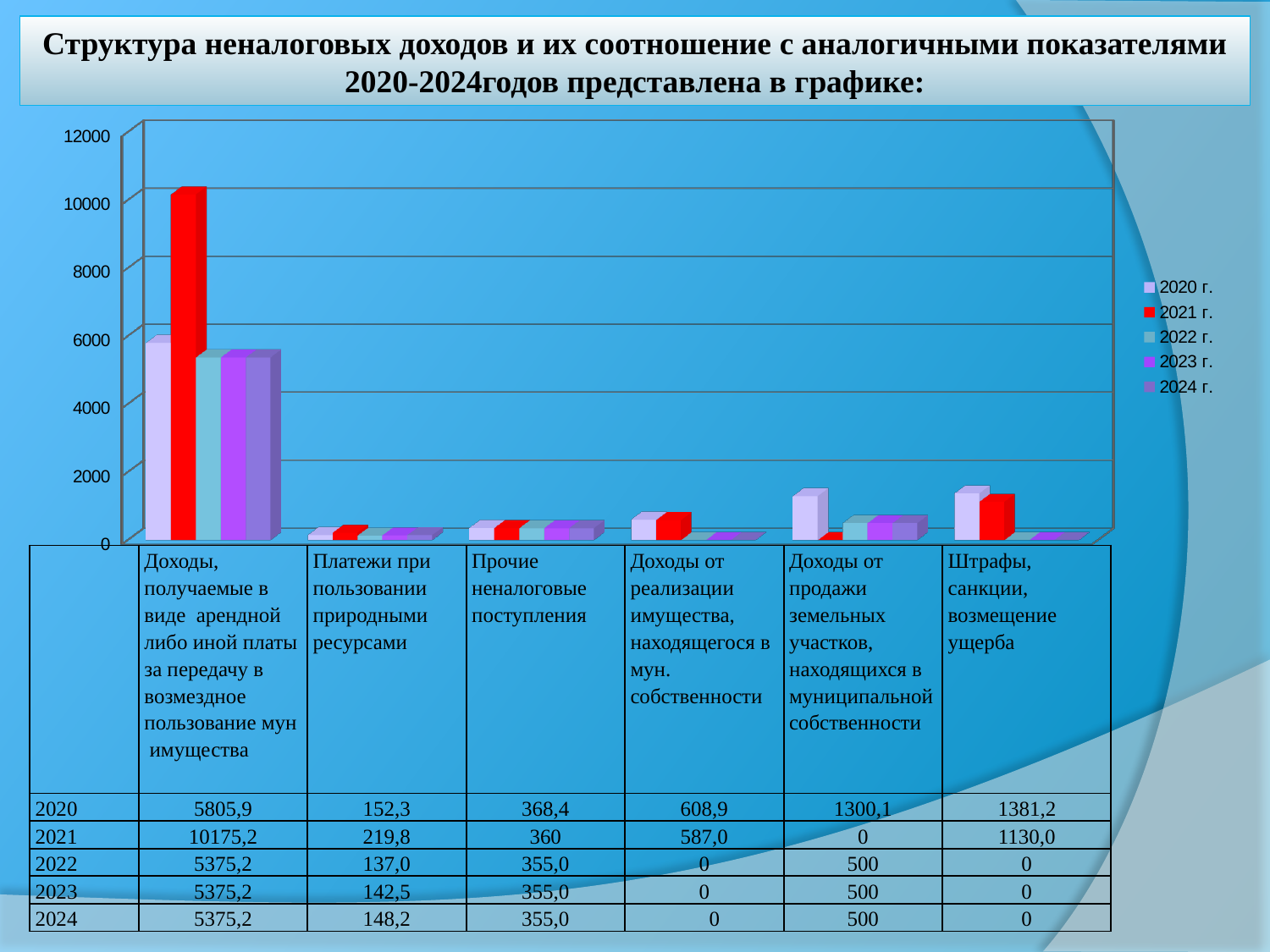
What is the value for 2024 in the category "Платежи при пользовании природными ресурсами"? 148,2 Which year has the highest value in the category "Доходы, получаемые в виде арендной либо иной платы за передачу в возмездное пользование мун имущества"? 2021 Which is larger in the category "Доходы от продажи земельных участков, находящихся в муниципальной собственности": the value for 2020 or the value for 2022? 2020 What is the difference between the 2021 and 2020 values in the category "Доходы, получаемые в виде арендной либо иной платы за передачу в возмездное пользование мун имущества"? 4369,3 What is the value for 2020 in the category "Штрафы, санкции, возмещение ущерба"? 1381,2 Is the 2021 value for "Доходы, получаемые в виде арендной либо иной платы за передачу в возмездное пользование мун имущества" greater or less than 8000? greater What kind of chart is shown on the slide? bar chart How many series does the legend list? 5 How many categories are shown on the x axis of the chart? 6 Which year has the lowest value in the category "Платежи при пользовании природными ресурсами"? 2022 Which colour represents the 2021 г. series in the legend? red What is the value for 2021 in the category "Доходы, получаемые в виде арендной либо иной платы за передачу в возмездное пользование мун имущества"? 10175,2